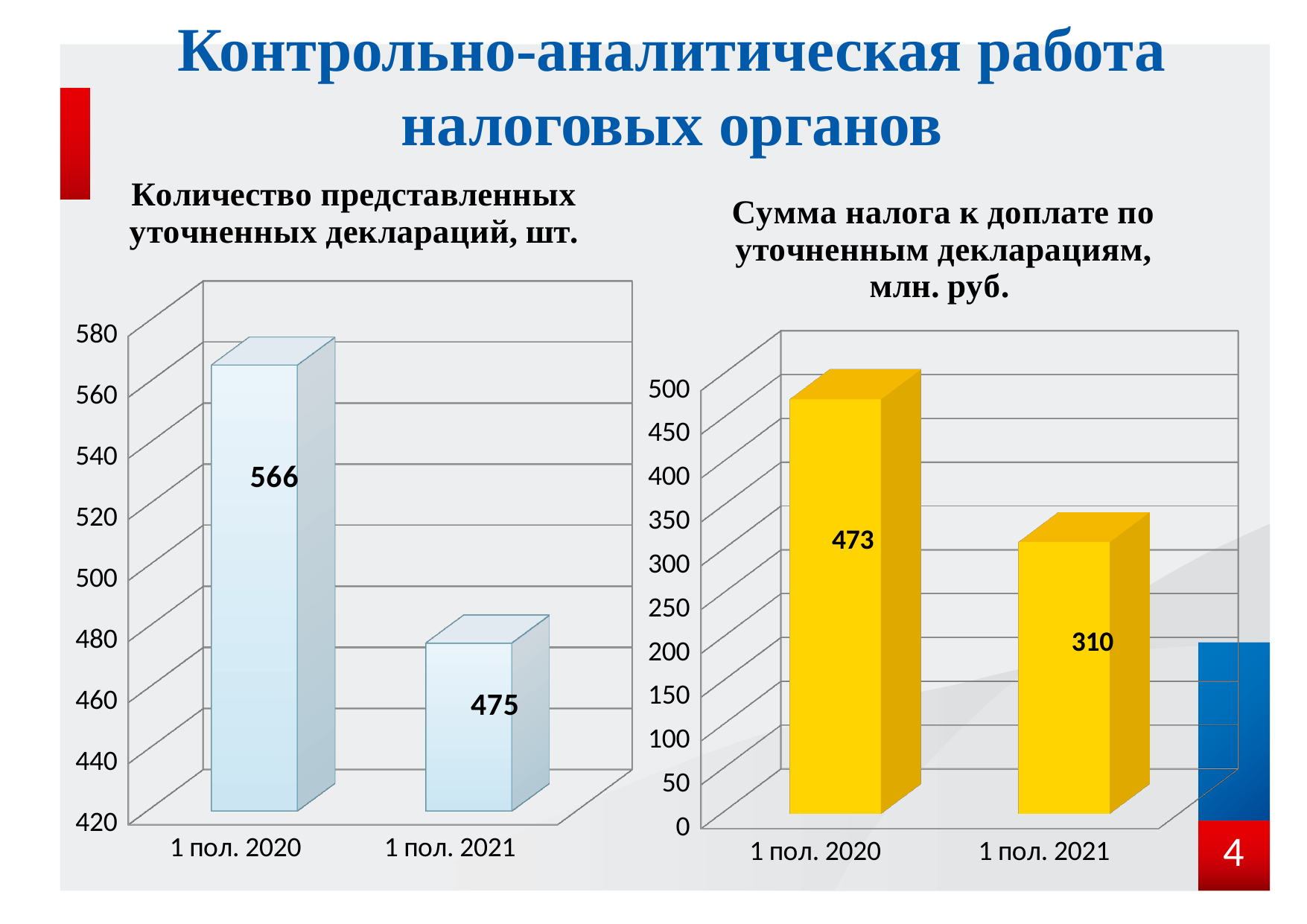
In the left chart (Количество представленных уточненных деклараций, шт.), what is the value for 1 пол. 2020? 566 What type of chart is the right chart (Сумма налога к доплате по уточненным декларациям, млн. руб.)? bar chart In the right chart, what is the difference between the values for 1 пол. 2020 and 1 пол. 2021? 163 In the left chart, what is the difference between the values for 1 пол. 2020 and 1 пол. 2021? 91 In the right chart, is the value for 1 пол. 2021 greater or less than 350? less In the left chart (Количество представленных уточненных деклараций, шт.), what is the value for 1 пол. 2021? 475 In the left chart, which period has the higher number of declarations? 1 пол. 2020 In the right chart (Сумма налога к доплате по уточненным декларациям, млн. руб.), what is the value for 1 пол. 2021? 310 In the right chart, do the values rise or fall from 1 пол. 2020 to 1 пол. 2021? fall In the right chart (Сумма налога к доплате по уточненным декларациям, млн. руб.), what is the value for 1 пол. 2020? 473 How many categories are shown on the x axis of the left chart? 2 In the right chart, which period has the lowest value? 1 пол. 2021